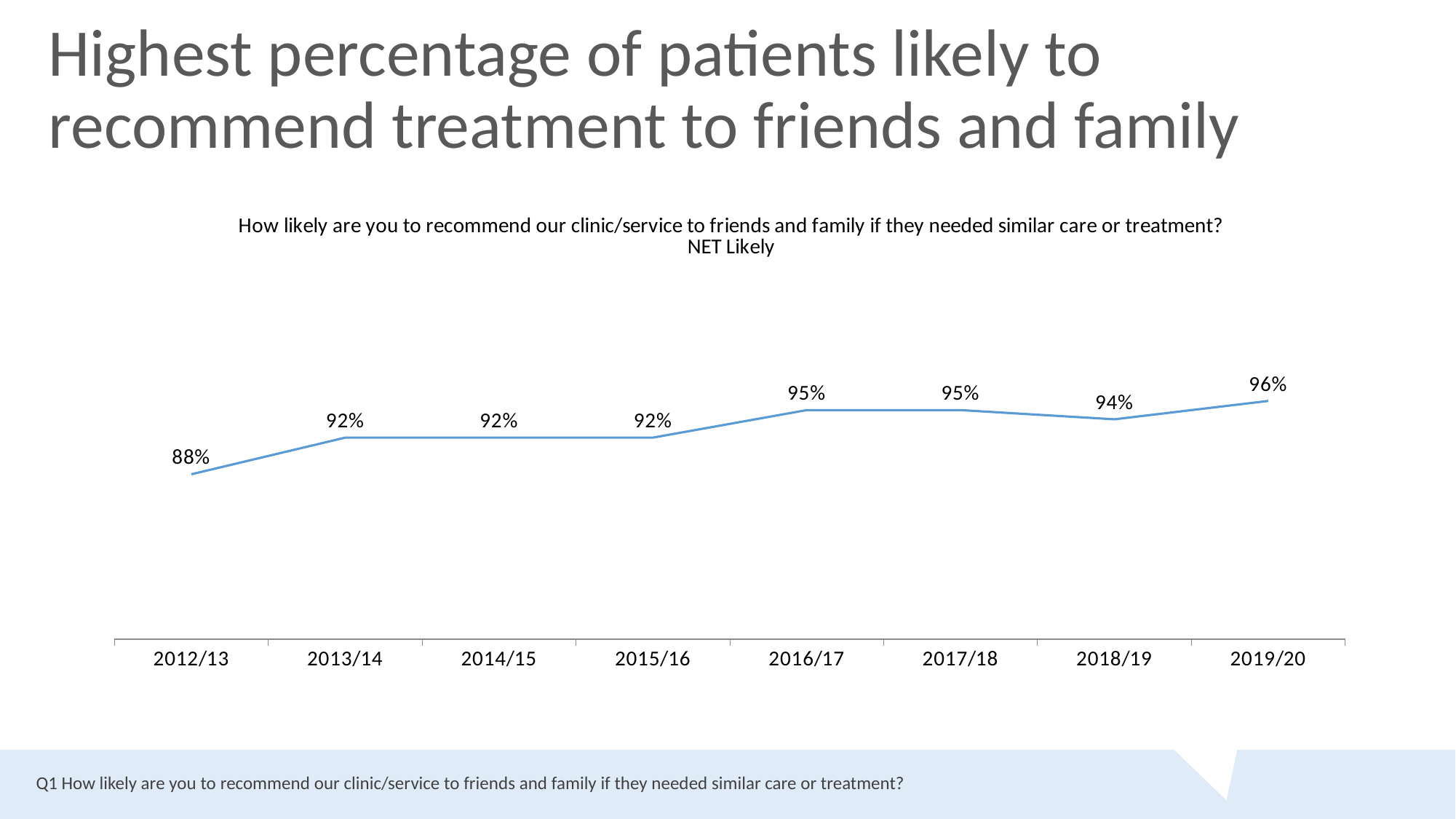
What is the NET Likely value for 2016/17? 95% How many years are plotted on the x axis? 8 What is the NET Likely value for 2019/20? 96% What is the difference between the NET Likely values for 2019/20 and 2012/13? 8% Which year has the highest NET Likely value? 2019/20 Which is larger, the NET Likely value for 2017/18 or for 2018/19? 2017/18 What is the NET Likely value for 2012/13? 88% Which year has the lowest NET Likely value? 2012/13 What is the NET Likely value for 2018/19? 94% What is the difference between the NET Likely values for 2016/17 and 2015/16? 3% What kind of chart is shown on the slide? Line chart Do the NET Likely values generally rise or fall from 2012/13 to 2019/20? Rise